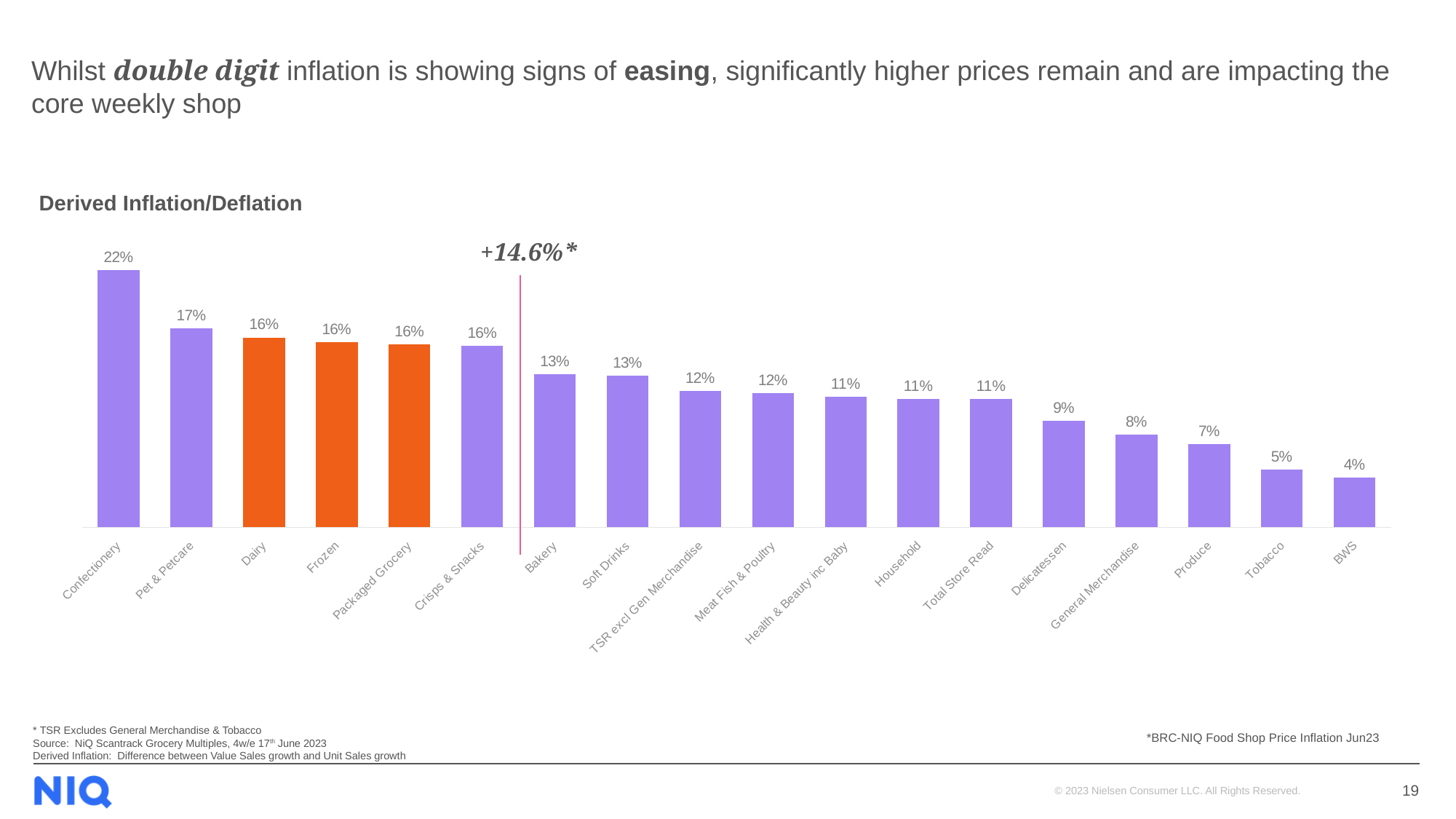
What is the derived inflation value for Total Store Read? 11% Which three categories are highlighted with orange bars? Dairy, Frozen, Packaged Grocery What is the derived inflation value for Bakery? 13% Which category has the highest derived inflation? Confectionery Which category has the lowest derived inflation? BWS How many categories are shown in the chart? 18 What kind of chart is shown on the slide? Bar chart What is the derived inflation value for Confectionery? 22% What is the difference between the derived inflation for Confectionery and for BWS? 18% What is the derived inflation value for Tobacco? 5% Which has a higher derived inflation value, Produce or General Merchandise? General Merchandise What is the difference between the derived inflation for Pet & Petcare and for Delicatessen? 8%